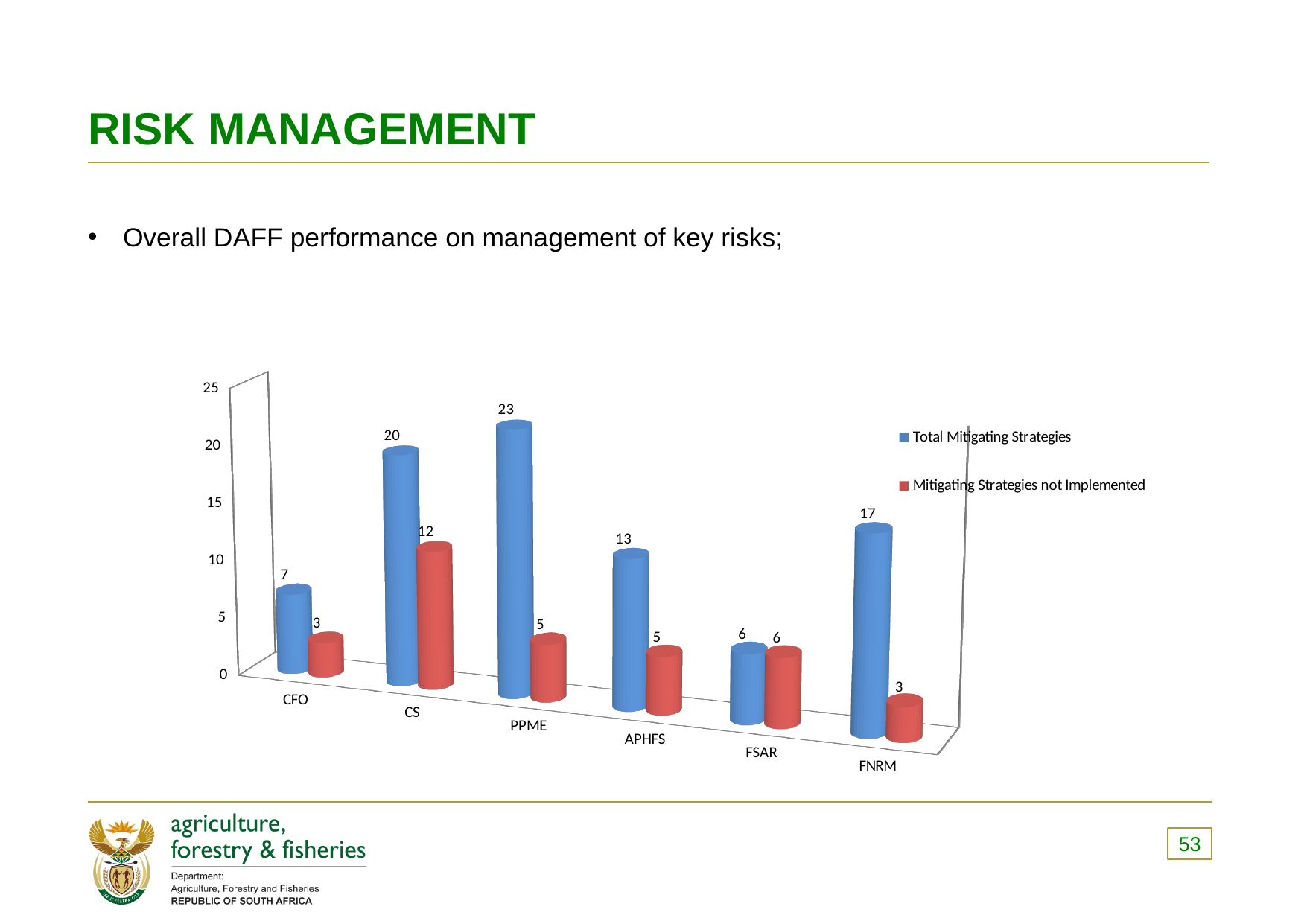
What is the value of Mitigating Strategies not Implemented for CS? 12 What is the value of Total Mitigating Strategies for PPME? 23 What colour are the bars for Mitigating Strategies not Implemented? Red What kind of chart is shown on the slide? Bar chart Which is larger: Mitigating Strategies not Implemented for CS or for APHFS? CS How many series does the legend list? 2 Which category has the highest value for Total Mitigating Strategies? PPME What is the value of Total Mitigating Strategies for FNRM? 17 How many categories are shown on the x axis? 6 What is the difference between Total Mitigating Strategies and Mitigating Strategies not Implemented for CFO? 4 Which category has the same value for both series? FSAR Which category has the lowest value for Total Mitigating Strategies? FSAR